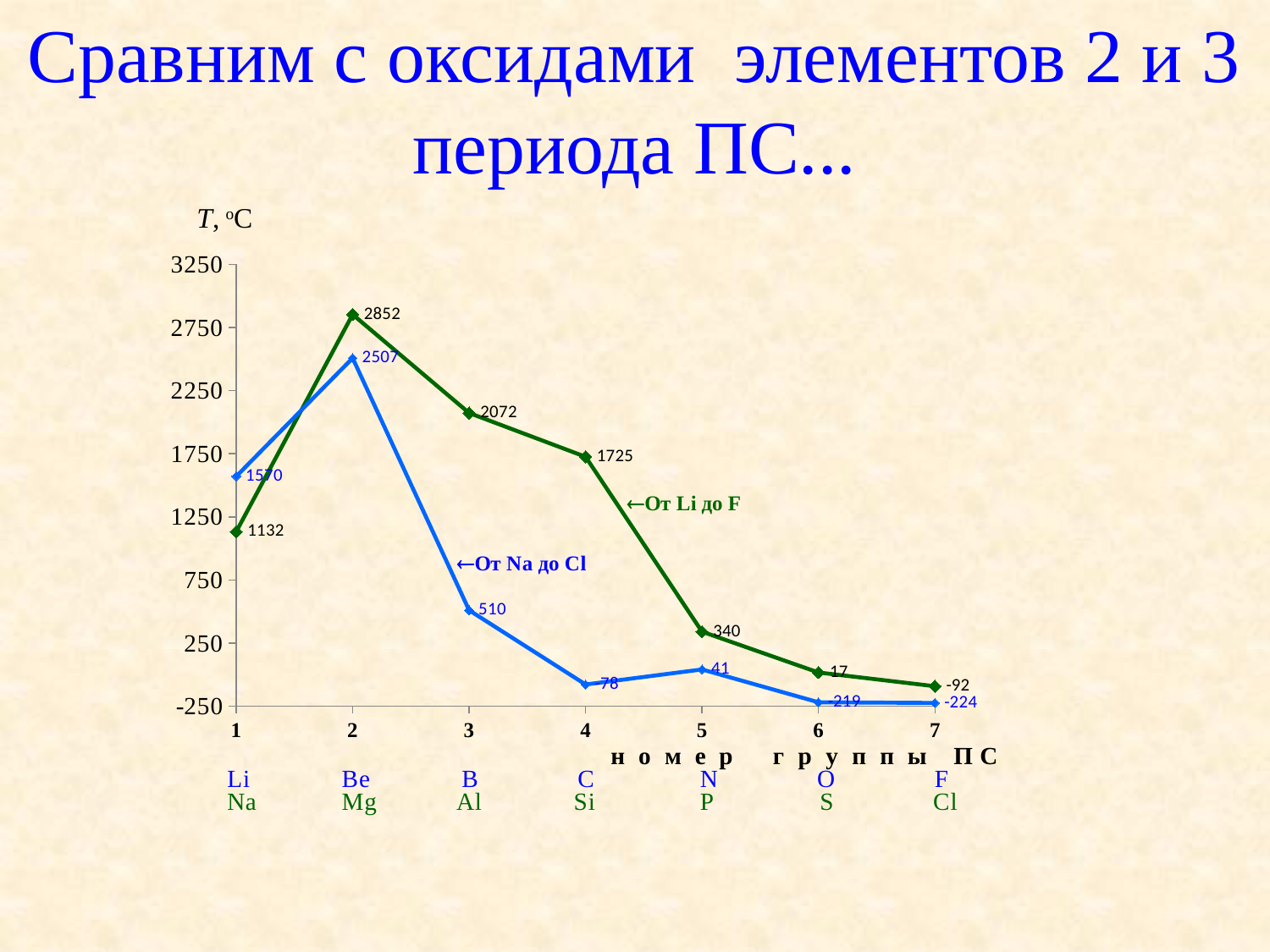
At group number 4, which series has the larger value, 'От Li до F' or 'От Na до Cl'? От Li до F How many data points does each series have? 7 How many data series are plotted on the chart? 2 What is the value of the 'От Na до Cl' series at group number 7? -224 What kind of chart is shown on the slide? line chart What is the value of the 'От Li до F' series at group number 5? 340 What is the value of the 'От Li до F' series at group number 2? 2852 What is the difference between the 'От Li до F' and 'От Na до Cl' values at group number 2? 345 What is the value of the 'От Na до Cl' series at group number 3? 510 At which group number does the 'От Li до F' series reach its highest value? 2 At which group number does the 'От Na до Cl' series have its lowest value? 7 From group number 2 to group number 7, does the 'От Li до F' series rise or fall? fall